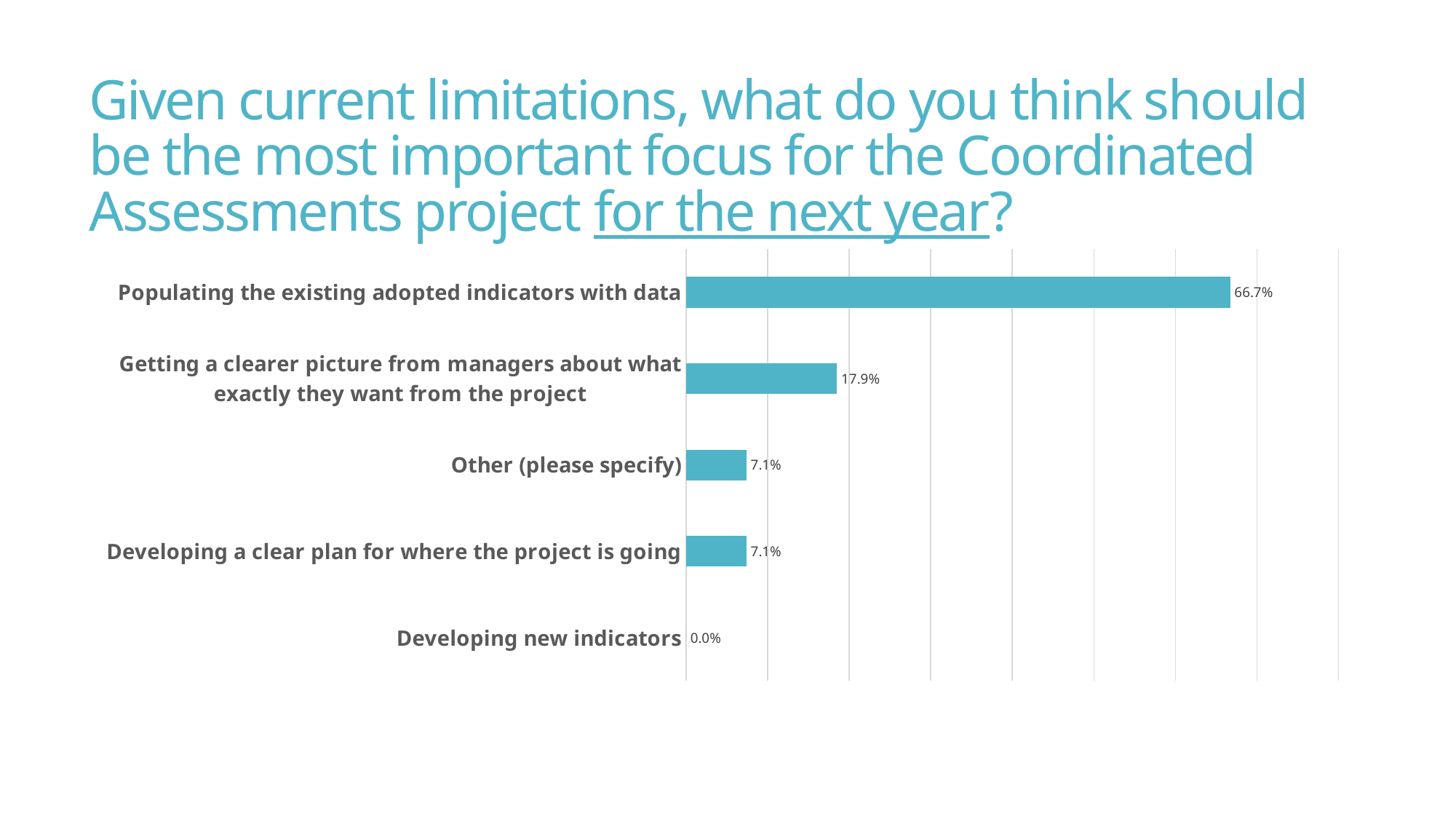
What is the difference between the values for 'Populating the existing adopted indicators with data' and 'Getting a clearer picture from managers about what exactly they want from the project'? 48.8% What is the difference between the values for 'Getting a clearer picture from managers about what exactly they want from the project' and 'Other (please specify)'? 10.8% What is the value for 'Developing new indicators'? 0.0% What is the value for 'Getting a clearer picture from managers about what exactly they want from the project'? 17.9% What percentage of respondents chose 'Populating the existing adopted indicators with data'? 66.7% Which is larger: the value for 'Getting a clearer picture from managers about what exactly they want from the project' or the value for 'Developing a clear plan for where the project is going'? Getting a clearer picture from managers about what exactly they want from the project Which category has the highest value? Populating the existing adopted indicators with data What is the value for 'Other (please specify)'? 7.1% What kind of chart is shown on the slide? Bar chart How many categories are shown in the chart? 5 What colour are the bars in the chart? Teal/blue Which category has the lowest value? Developing new indicators